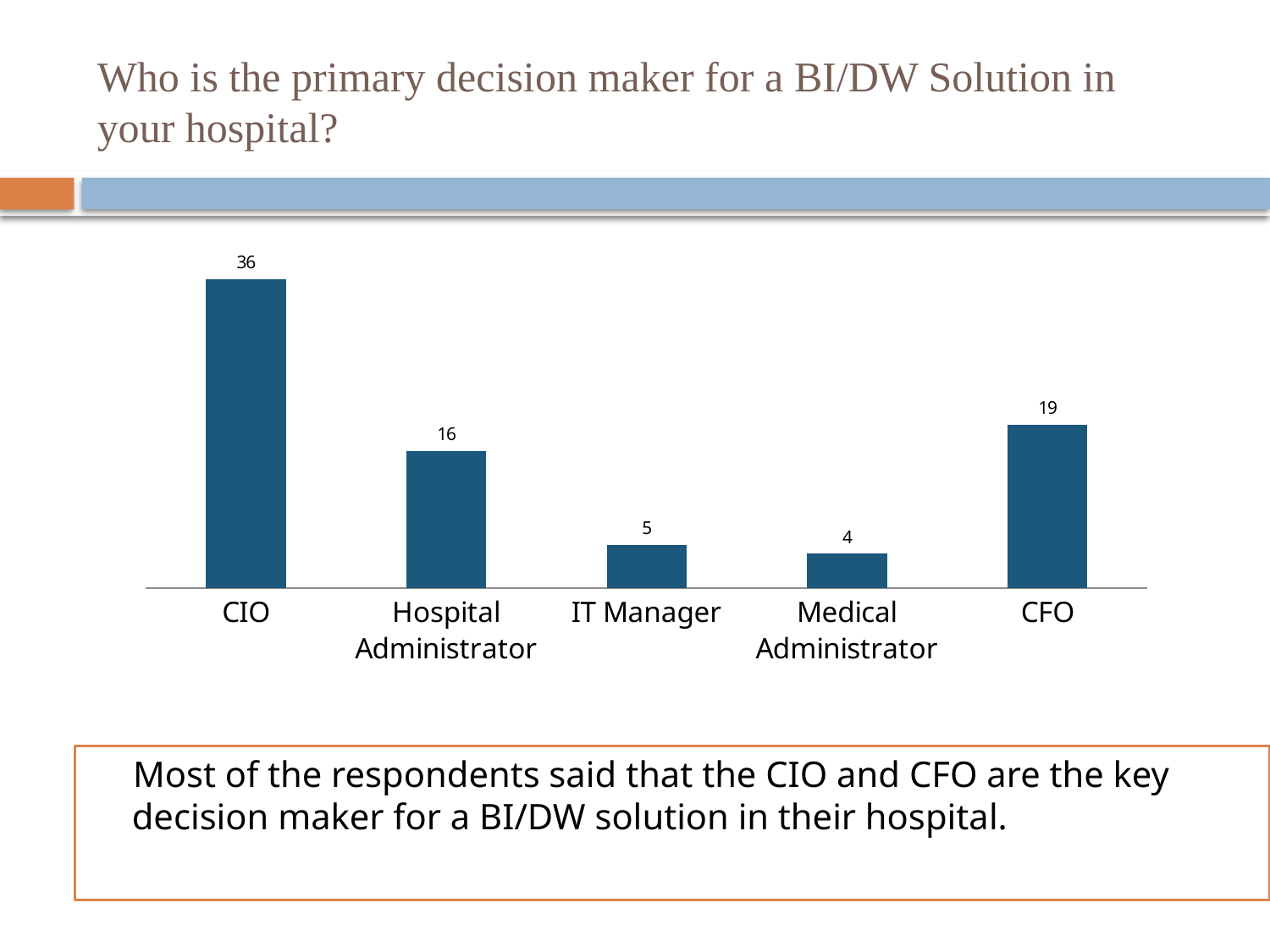
How many categories are shown on the chart? 5 Which is larger, the value for CFO or the value for Hospital Administrator? CFO What is the value for CIO? 36 What is the difference between the values for CIO and CFO? 17 Which category has the highest value? CIO What kind of chart is shown on the slide? Bar chart What is the value for CFO? 19 What is the value for Medical Administrator? 4 Which category has the lowest value? Medical Administrator What is the difference between the values for Hospital Administrator and IT Manager? 11 What is the value for IT Manager? 5 What is the value for Hospital Administrator? 16